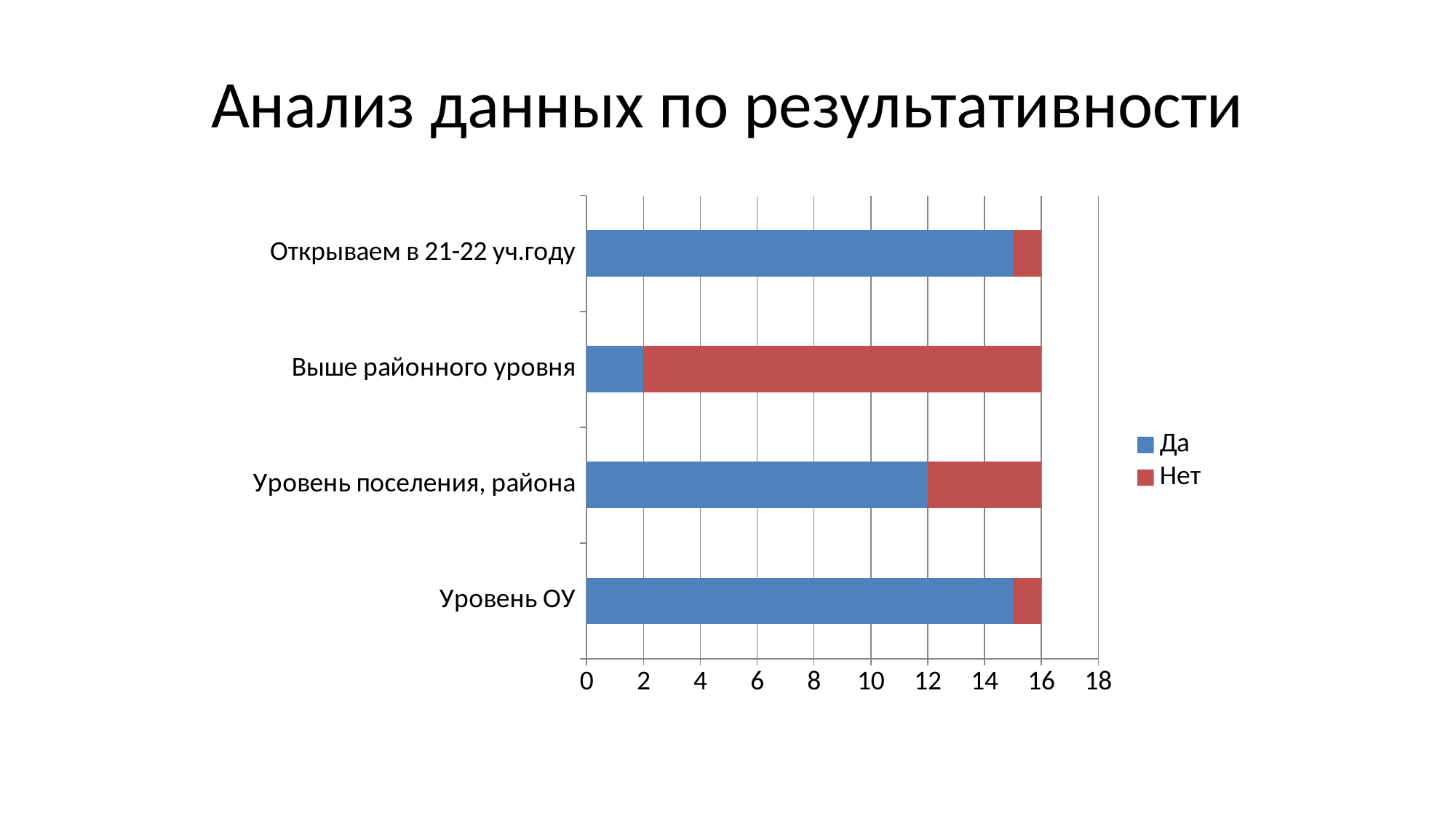
What kind of chart is shown on the slide? bar chart Which category has the largest "Нет" value? Выше районного уровня Is the value of "Да" for "Уровень ОУ" greater or less than 14? greater What is the value of "Да" for "Уровень поселения, района"? 12 Is the value of "Нет" for "Открываем в 21-22 уч.году" greater or less than 2? less How many categories are shown on the chart? 4 How many series does the legend list? 2 What is the title of the slide? Анализ данных по результативности Which has the larger "Да" value: "Уровень поселения, района" or "Выше районного уровня"? Уровень поселения, района Which category has the smallest "Да" value? Выше районного уровня What is the value of "Да" for "Выше районного уровня"? 2 What is the total of the stacked bar for "Уровень ОУ"? 16